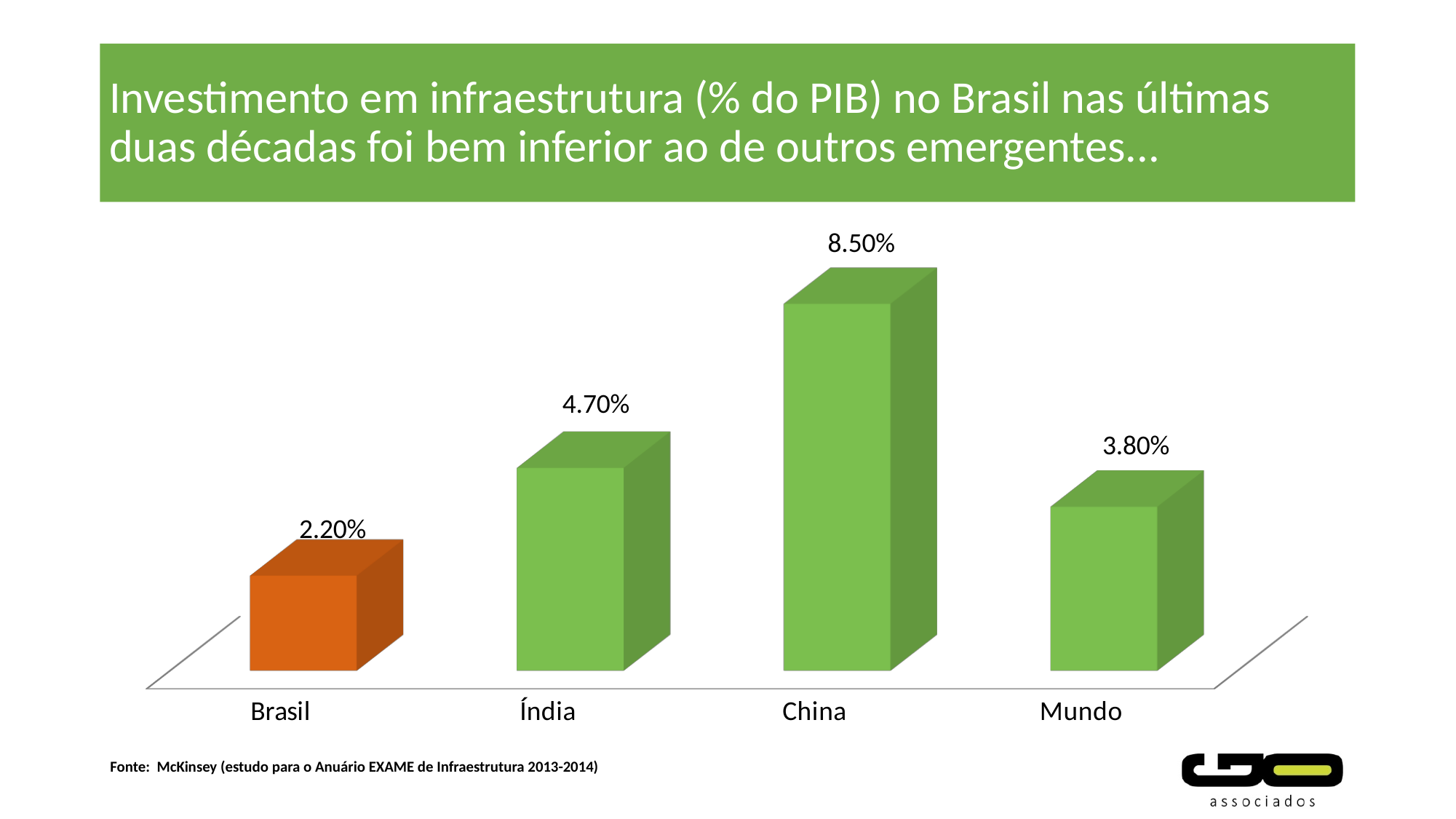
What is the value for Mundo? 3.80% What is the difference between the values for Índia and Mundo? 0.90% What kind of chart is shown on the slide? Bar chart What is the difference between the values for China and Brasil? 6.30% What is the value for Índia? 4.70% How many categories are shown in the chart? 4 What is the value for Brasil? 2.20% Which category has the lowest value? Brasil Which bar is coloured orange instead of green? Brasil Which category has the highest value? China Which is larger, the value for Índia or the value for Mundo? Índia What is the value for China? 8.50%